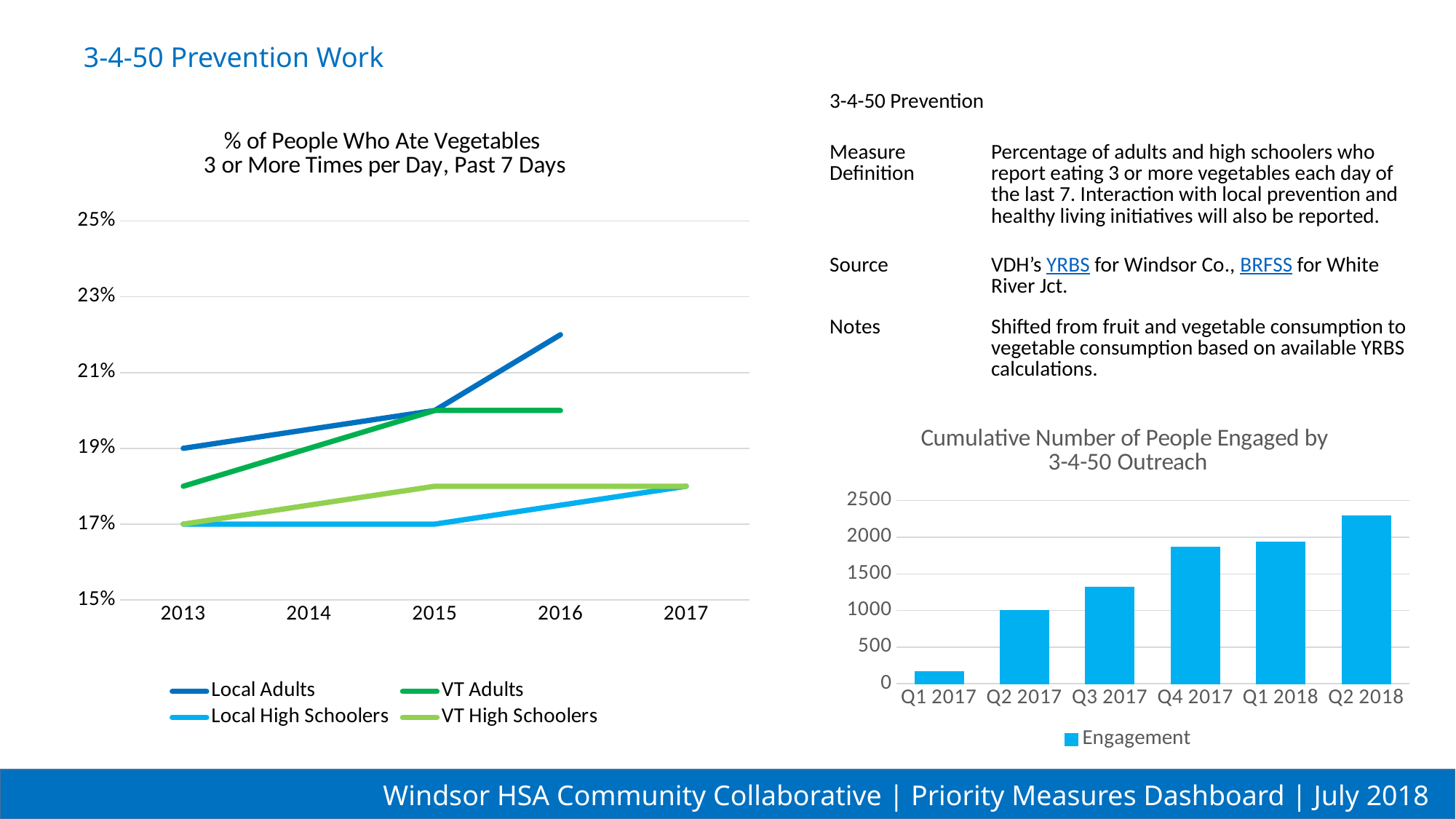
In the chart titled '% of People Who Ate Vegetables 3 or More Times per Day, Past 7 Days', what is the value for Local Adults in 2013? 19% In the chart titled 'Cumulative Number of People Engaged by 3-4-50 Outreach', what kind of chart is shown? bar chart In the chart titled '% of People Who Ate Vegetables 3 or More Times per Day, Past 7 Days', does the Local Adults line rise or fall from 2013 to 2016? rise In the chart titled '% of People Who Ate Vegetables 3 or More Times per Day, Past 7 Days', what kind of chart is shown? line chart In the chart titled '% of People Who Ate Vegetables 3 or More Times per Day, Past 7 Days', which series has the highest value in 2016? Local Adults In the chart titled '% of People Who Ate Vegetables 3 or More Times per Day, Past 7 Days', how many series does the legend list? 4 In the chart titled '% of People Who Ate Vegetables 3 or More Times per Day, Past 7 Days', what is the value for Local High Schoolers in 2013? 17% In the chart titled 'Cumulative Number of People Engaged by 3-4-50 Outreach', which quarter has the lowest value? Q1 2017 In the chart titled '% of People Who Ate Vegetables 3 or More Times per Day, Past 7 Days', is the value for Local Adults in 2016 greater or less than 21%? greater In the chart titled 'Cumulative Number of People Engaged by 3-4-50 Outreach', how many quarters are shown on the x axis? 6 In the chart titled 'Cumulative Number of People Engaged by 3-4-50 Outreach', which quarter has the highest value? Q2 2018 In the chart titled 'Cumulative Number of People Engaged by 3-4-50 Outreach', is the value for Q2 2018 greater or less than 2000? greater